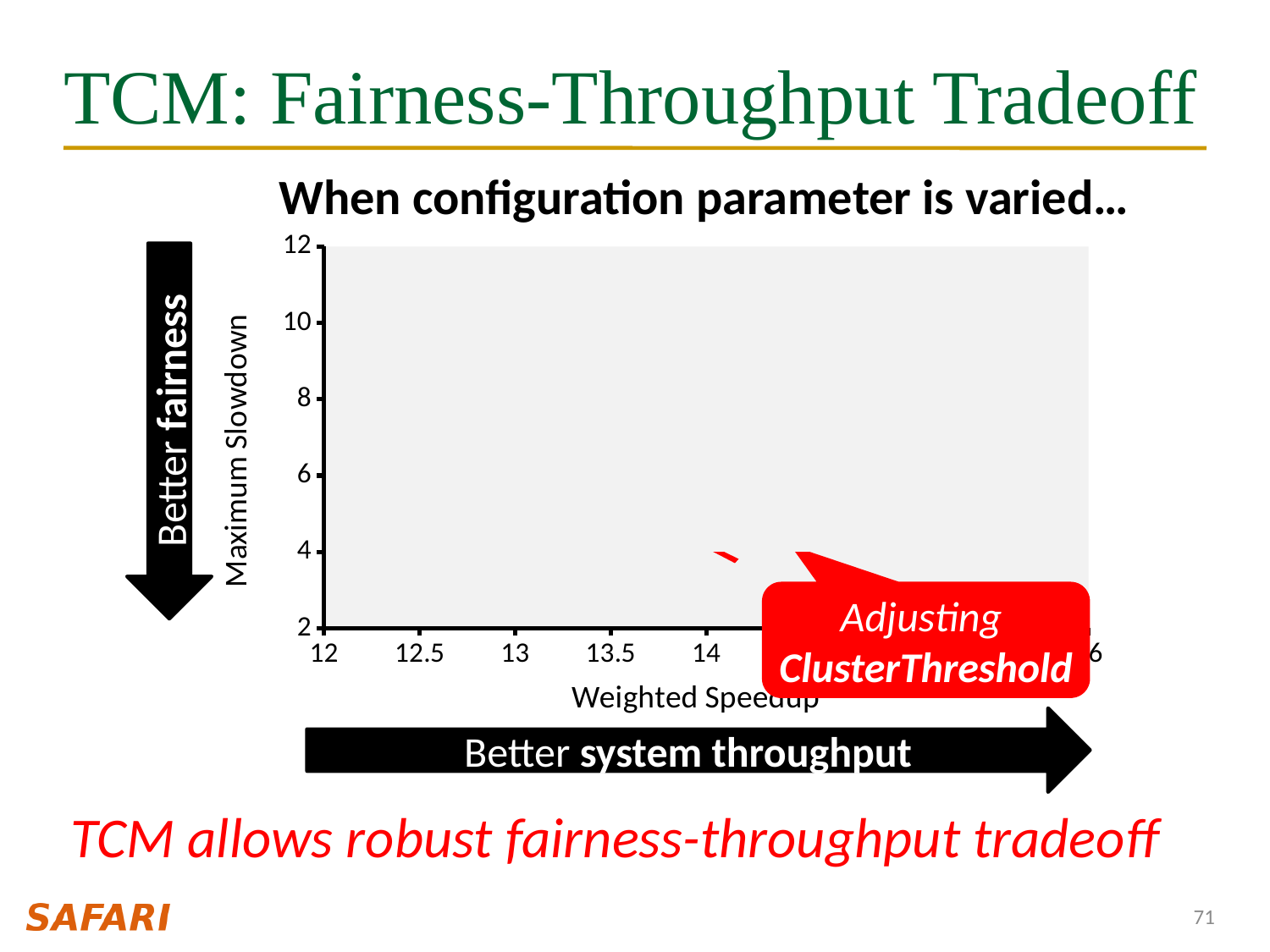
Is the Maximum Slowdown of the visible red data point greater or less than 6? less Is the Weighted Speedup of the visible red data point greater or less than 13? greater What is the title of the chart? When configuration parameter is varied… Is the Weighted Speedup of the visible red data point greater or less than 13.5? greater What is the label of the x axis of the chart? Weighted Speedup What kind of chart is shown on the slide? scatter chart